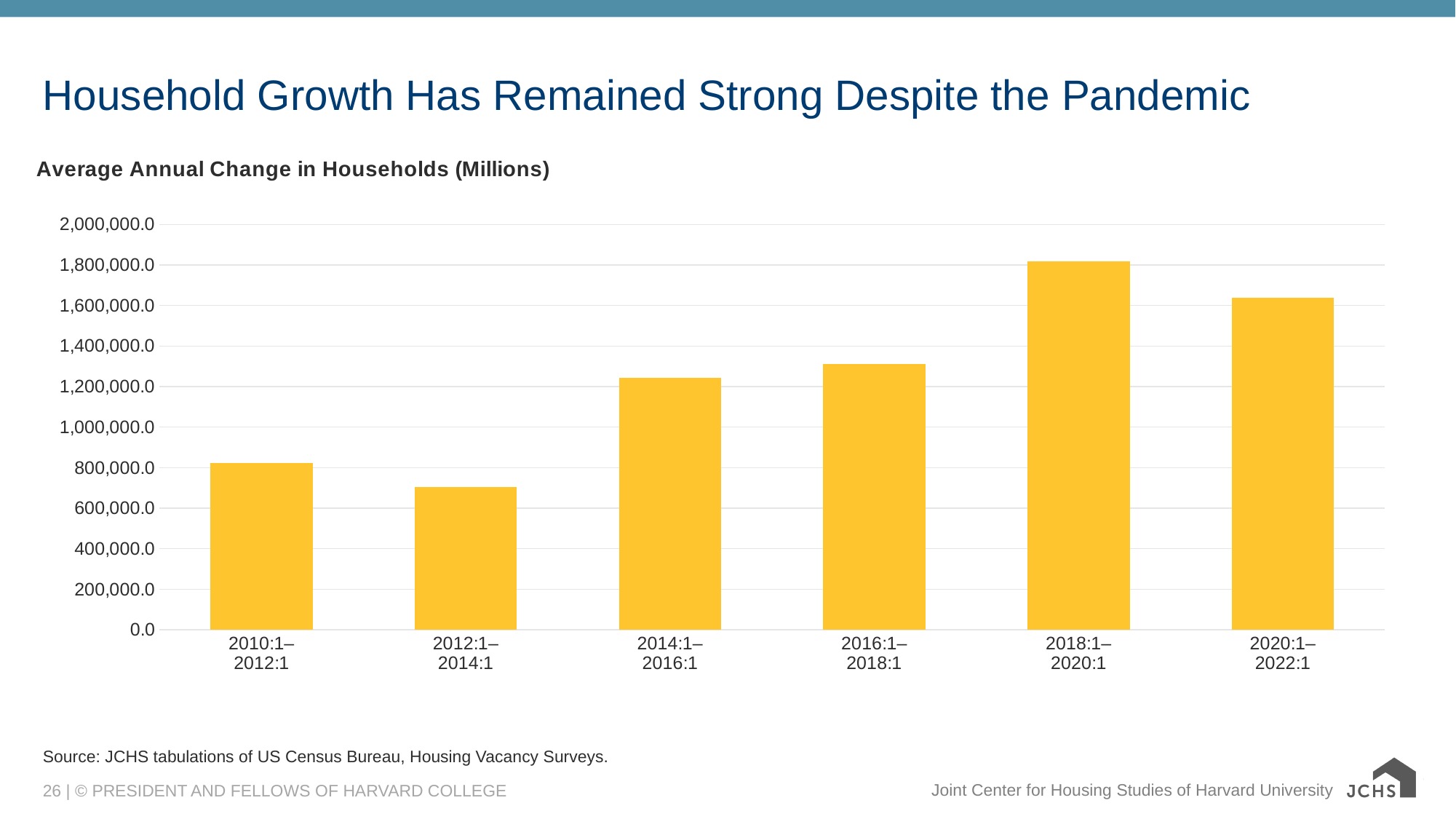
Do the values generally rise or fall from 2012:1–2014:1 through 2018:1–2020:1? rise Is the value for 2018:1–2020:1 greater or less than 1,600,000.0? greater What is the title of the chart (the label above the plot area)? Average Annual Change in Households (Millions) Which period has the highest average annual change in households? 2018:1–2020:1 Which period has the larger value, 2010:1–2012:1 or 2012:1–2014:1? 2010:1–2012:1 Is the value for 2020:1–2022:1 greater or less than 1,800,000.0? less Which period has the larger value, 2020:1–2022:1 or 2018:1–2020:1? 2018:1–2020:1 Is the value for 2014:1–2016:1 greater or less than 1,000,000.0? greater How many periods (bars) are plotted on the chart? 6 Which period has the lowest average annual change in households? 2012:1–2014:1 What kind of chart is shown on the slide? bar chart